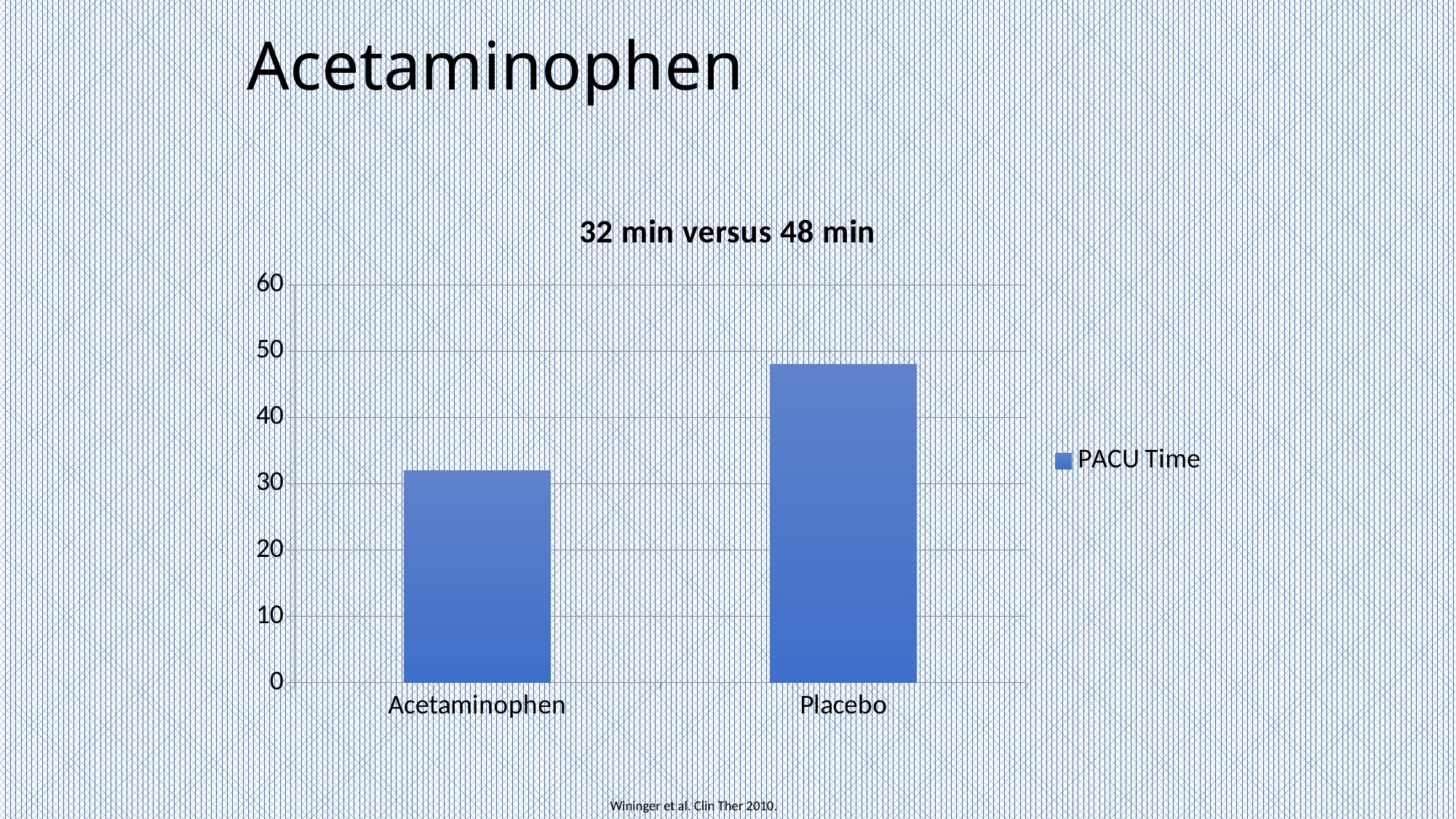
Which category has the lowest PACU Time? Acetaminophen What is the PACU Time value for Placebo? 48 min What is the difference in PACU Time between Placebo and Acetaminophen? 16 min Which is larger, the PACU Time for Acetaminophen or for Placebo? Placebo What type of chart is shown on the slide? bar chart How many categories are shown on the x axis? 2 What is the title of the chart? 32 min versus 48 min What is the PACU Time value for Acetaminophen? 32 min Is the PACU Time for Placebo greater or less than 40? greater What series does the legend list? PACU Time Which category has the highest PACU Time? Placebo How many series does the legend list? 1